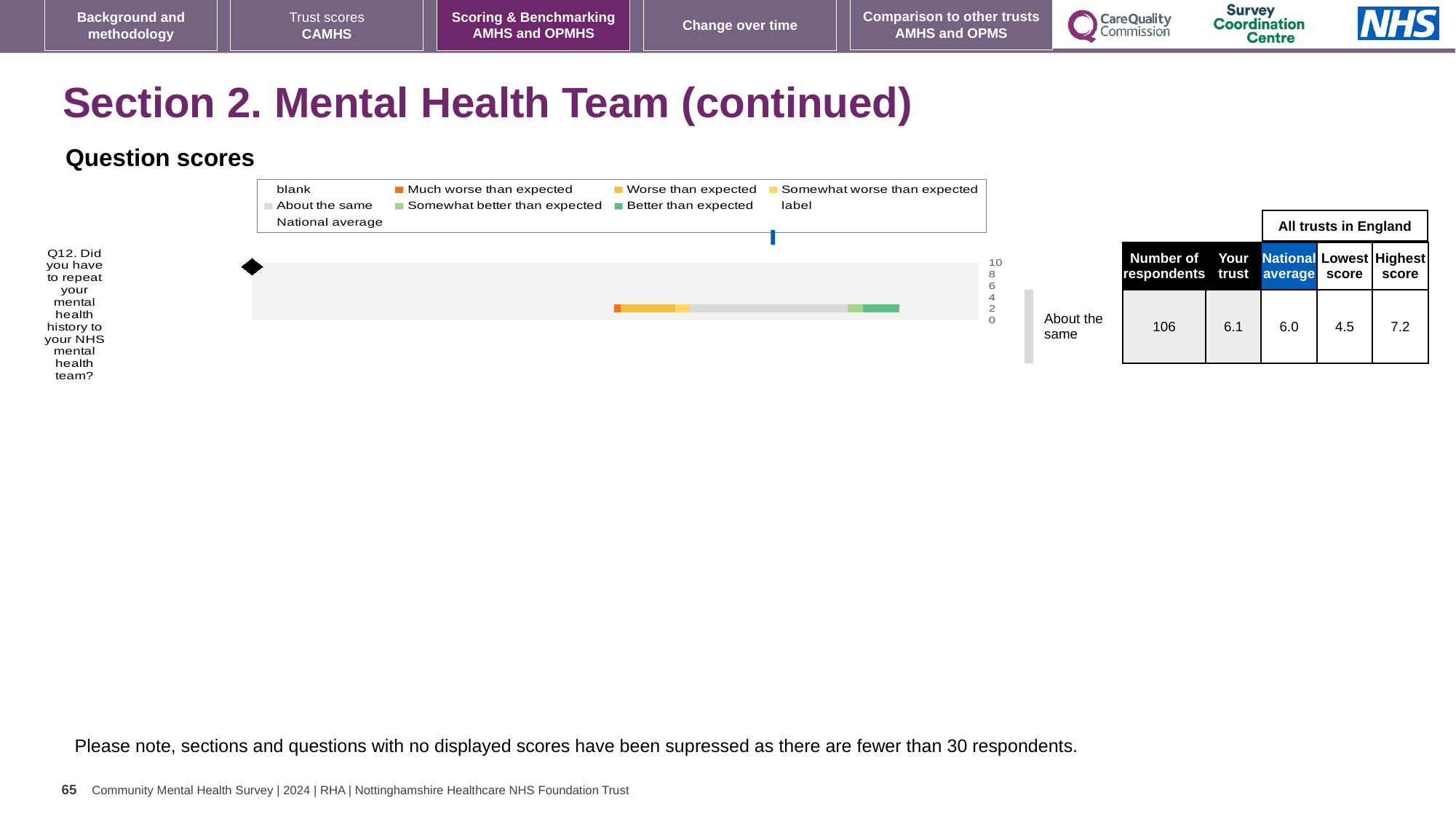
What is the 'Your trust' score for Q12 (Did you have to repeat your mental health history to your NHS mental health team?)? 6.1 What is the national average score for Q12? 6.0 Which benchmark category is the trust's Q12 score placed in? About the same How many survey questions are plotted in the chart? 1 What colour represents 'Much worse than expected' in the legend? orange Which is larger for Q12, the trust's score or the national average? the trust's score How many respondents answered Q12? 106 What is the highest score among all trusts in England for Q12? 7.2 What kind of chart is shown on the slide for Q12? bar chart What is the difference between the highest and lowest scores for Q12 across all trusts in England? 2.7 Is the trust's score for Q12 greater or less than 8 on the axis? less What is the lowest score among all trusts in England for Q12? 4.5